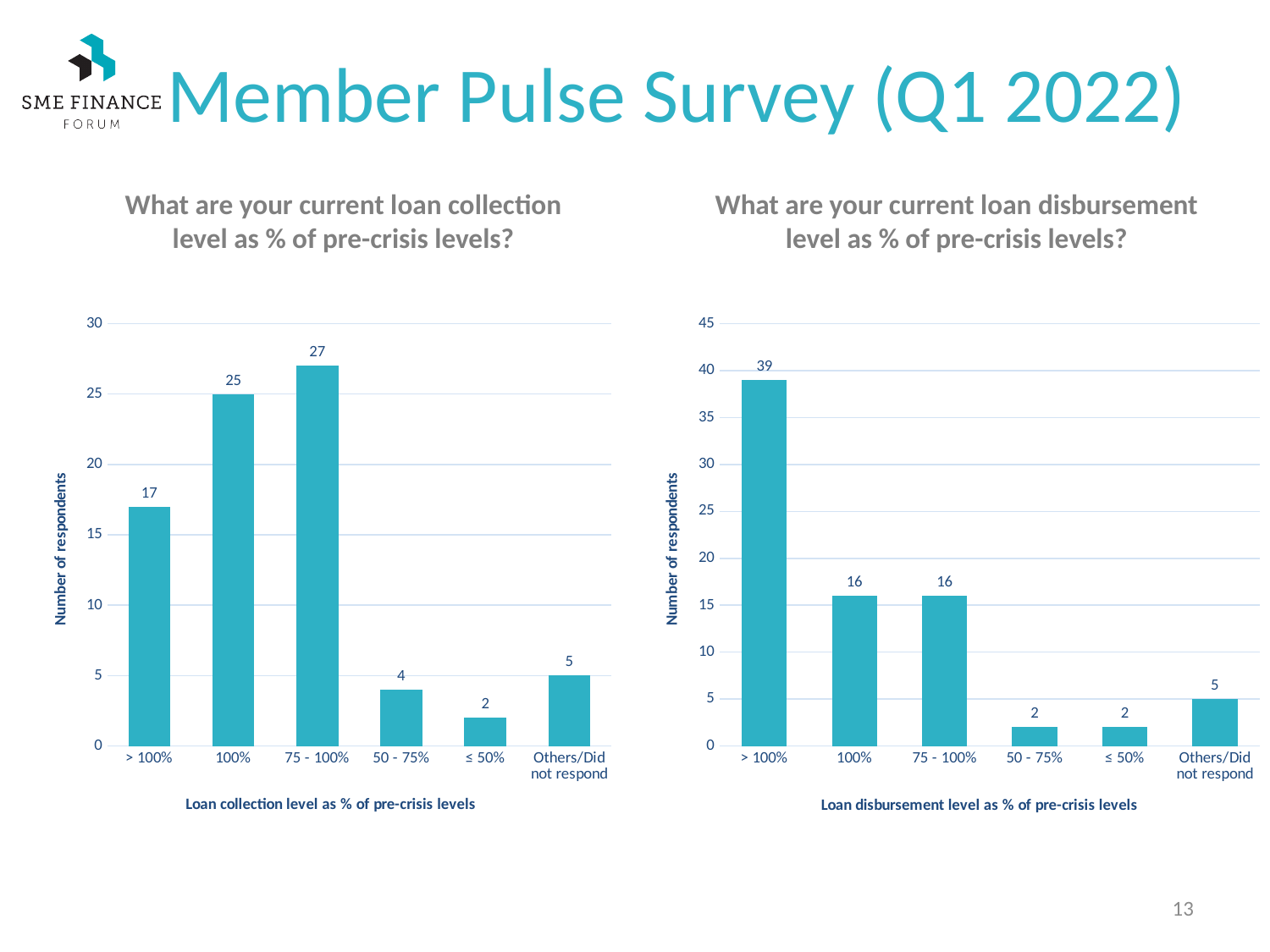
In the loan disbursement chart (right), which category has the highest number of respondents? > 100% In the loan disbursement chart (right), what is the difference in respondents between > 100% and 100%? 23 In the loan disbursement chart (right), how many respondents reported a disbursement level of > 100%? 39 In the loan collection chart (left), which has more respondents: 50 - 75% or Others/Did not respond? Others/Did not respond In the loan disbursement chart (right), is the value for > 100% greater or less than 35? greater In the loan collection chart (left), which category has the highest number of respondents? 75 - 100% What type of chart is the loan collection chart (left)? Bar chart In the loan collection chart (left), what is the difference in respondents between the 100% and > 100% categories? 8 In the loan collection chart (left), which category has the lowest number of respondents? ≤ 50% How many categories are shown on the x axis of the loan disbursement chart (right)? 6 In the loan collection chart (left), how many respondents reported a collection level of 75 - 100%? 27 What is the y-axis label of the loan disbursement chart (right)? Number of respondents